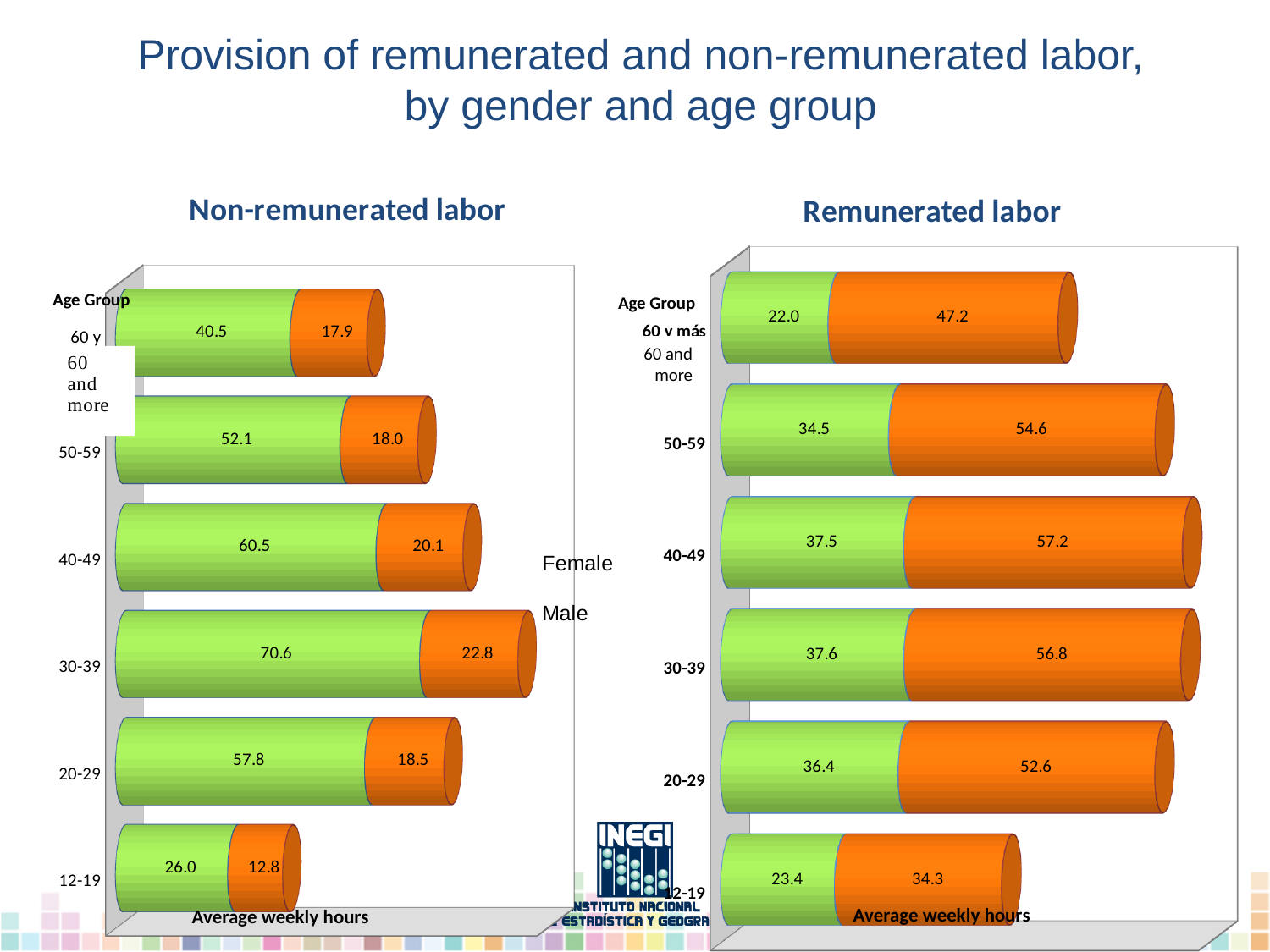
In the Non-remunerated labor chart, what is the Male value for the 12-19 age group? 12.8 In the Non-remunerated labor chart, what is the Female value for the 30-39 age group? 70.6 How many age groups are shown in the Non-remunerated labor chart? 6 What type of chart is the Remunerated labor chart? Stacked bar chart In the Remunerated labor chart, which age group has the lowest Male value? 12-19 How many series does the legend list? 2 In the Non-remunerated labor chart, which age group has the highest Female value? 30-39 In the Non-remunerated labor chart, what is the difference between the Female and Male values for the 40-49 age group? 40.4 In the Remunerated labor chart, is the Male value for the 20-29 age group larger than the Female value for the same group? Yes In the Remunerated labor chart, what is the Male value for the 40-49 age group? 57.2 In the Remunerated labor chart, what is the Female value for the 60 and more age group? 22.0 In the Remunerated labor chart, what is the total of the stacked bar for the 50-59 age group? 89.1